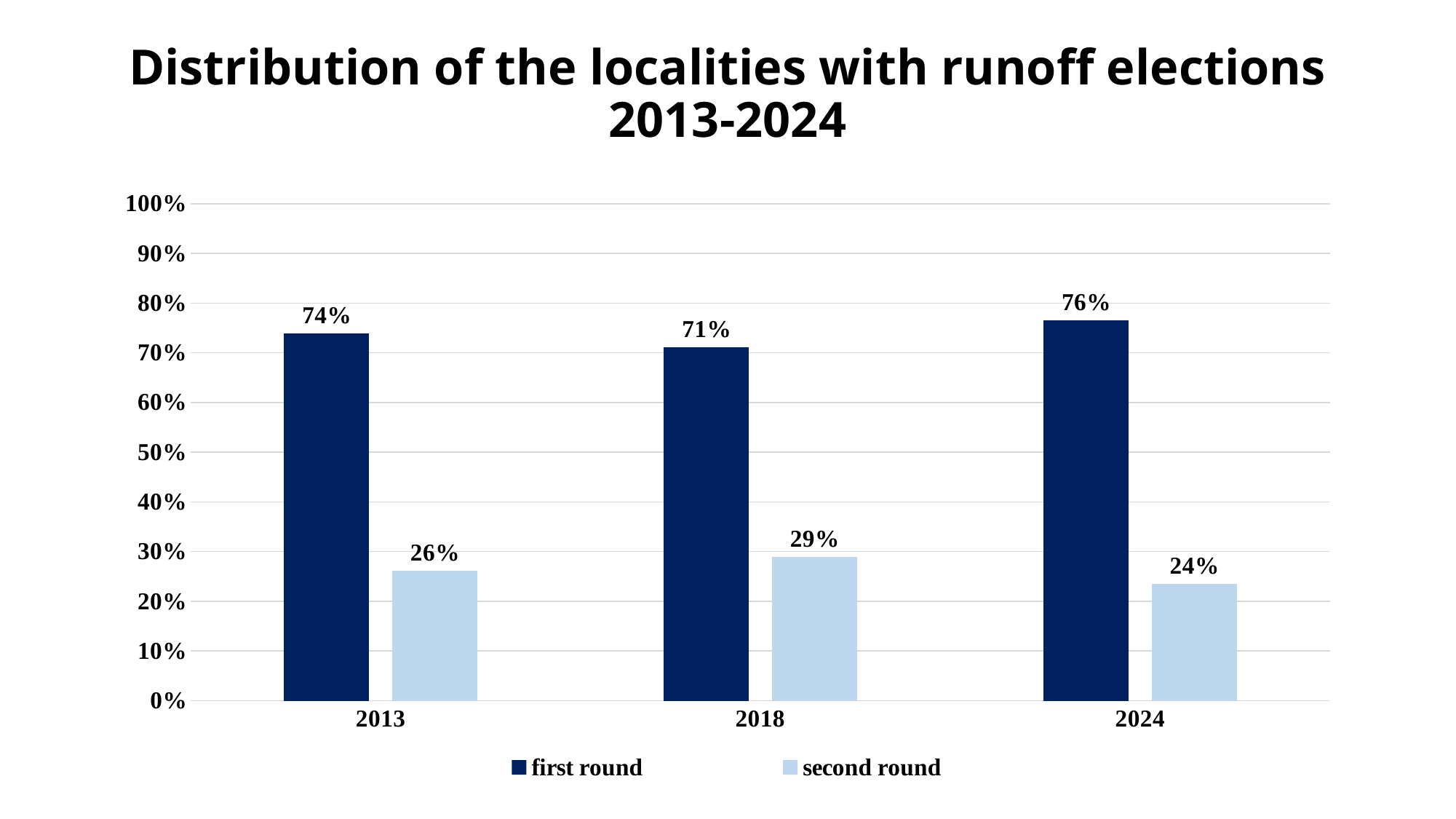
What is the value for second round in 2018? 29% What is the value for first round in 2013? 74% In which year is the second round value lowest? 2024 Which is larger, the first round value in 2013 or the first round value in 2018? 2013 What kind of chart is shown on the slide? Bar chart What is the value for second round in 2024? 24% What is the title of the chart? Distribution of the localities with runoff elections 2013-2024 What is the difference between the first round and second round values in 2018? 42% How many years are shown on the x axis? 3 How many series does the legend list? 2 In which year is the first round value highest? 2024 What is the value for first round in 2024? 76%